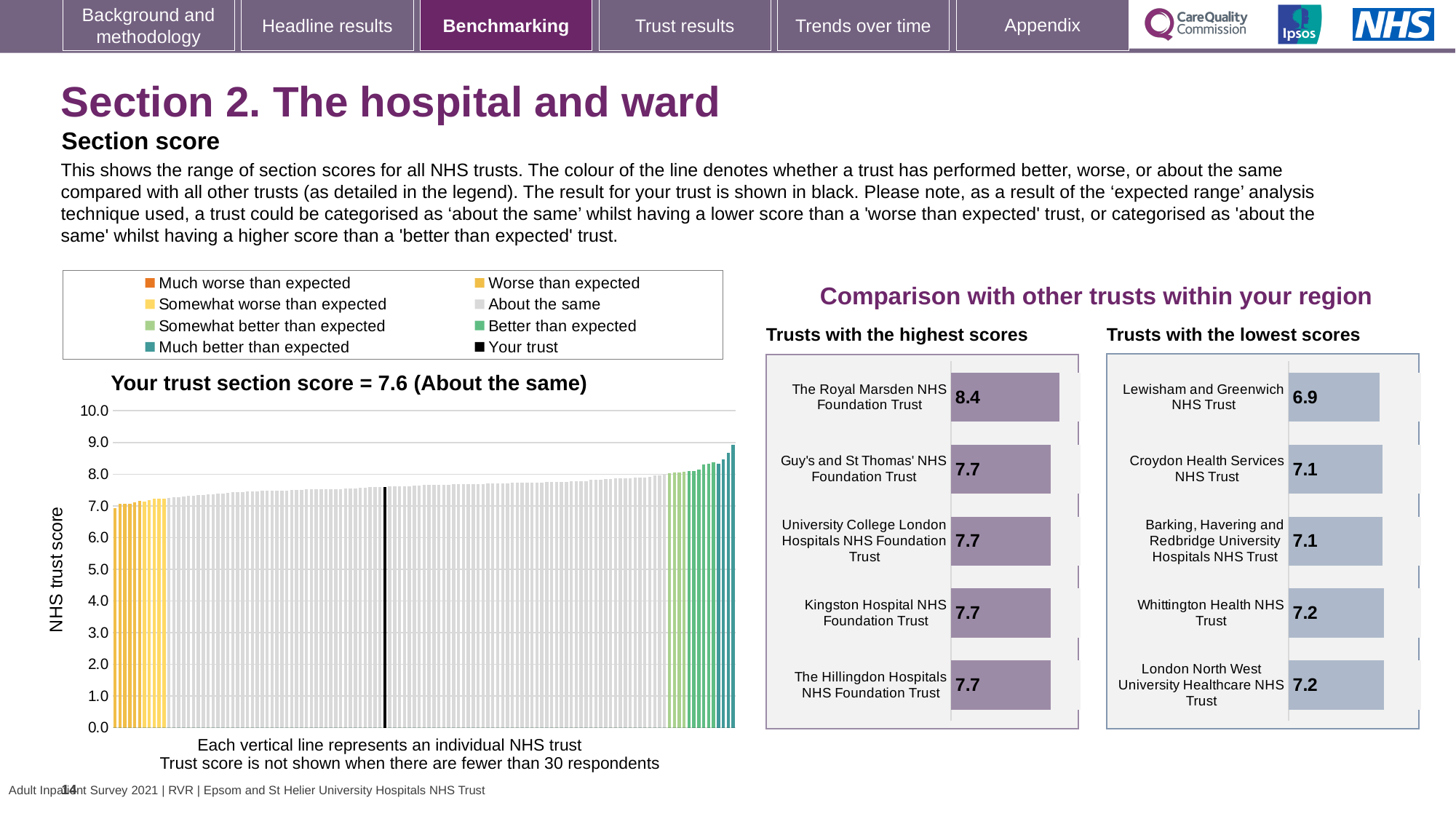
In the 'Trusts with the highest scores' chart, which trust has the highest score? The Royal Marsden NHS Foundation Trust In the 'Trusts with the lowest scores' chart, which has the higher score: Croydon Health Services NHS Trust or Whittington Health NHS Trust? Whittington Health NHS Trust In the 'Trusts with the lowest scores' chart, what is the score for Lewisham and Greenwich NHS Trust? 6.9 In the 'Trusts with the highest scores' chart, what is the score for The Royal Marsden NHS Foundation Trust? 8.4 In the 'Trusts with the highest scores' chart, what is the difference between the scores of The Royal Marsden NHS Foundation Trust and Kingston Hospital NHS Foundation Trust? 0.7 In the 'Trusts with the lowest scores' chart, which trust has the lowest score? Lewisham and Greenwich NHS Trust In the main chart on the left, what is the section score for your trust? 7.6 In the main chart on the left, do the bar values rise or fall from left to right? rise In the main chart on the left, is the value of the tallest bar greater or less than 8.0? greater In the 'Trusts with the lowest scores' chart, what is the difference between the scores of Whittington Health NHS Trust and Lewisham and Greenwich NHS Trust? 0.3 How many trusts are shown in the 'Trusts with the highest scores' chart? 5 How many entries does the legend above the main chart on the left list? 8